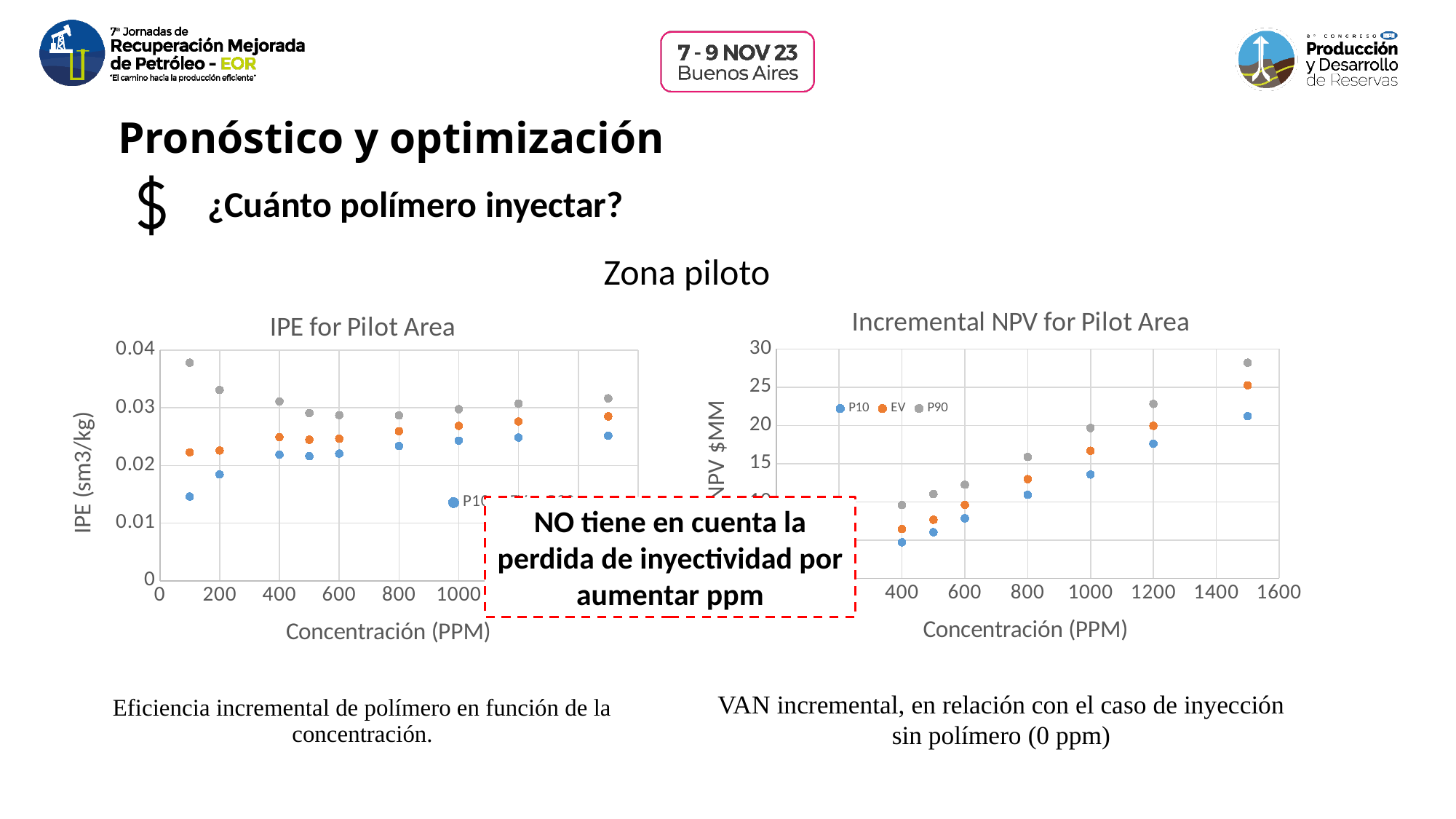
In the "IPE for Pilot Area" chart, is the P90 value at 100 ppm greater or less than 0.03? greater In the "Incremental NPV for Pilot Area" chart, is the EV value at 1000 ppm greater or less than 15? greater In the "Incremental NPV for Pilot Area" chart, is the P90 value at 1500 ppm greater or less than 25? greater How many series does the legend of the "Incremental NPV for Pilot Area" chart list? 3 In the "Incremental NPV for Pilot Area" chart, which is larger at 1500 ppm: the P10 value or the EV value? EV In the "Incremental NPV for Pilot Area" chart, do the NPV values rise or fall as concentration increases? rise In the "Incremental NPV for Pilot Area" chart, which series has the highest values at every concentration? P90 What kind of chart is the "IPE for Pilot Area" chart? scatter chart What is the y-axis label of the "IPE for Pilot Area" chart? IPE (sm3/kg)